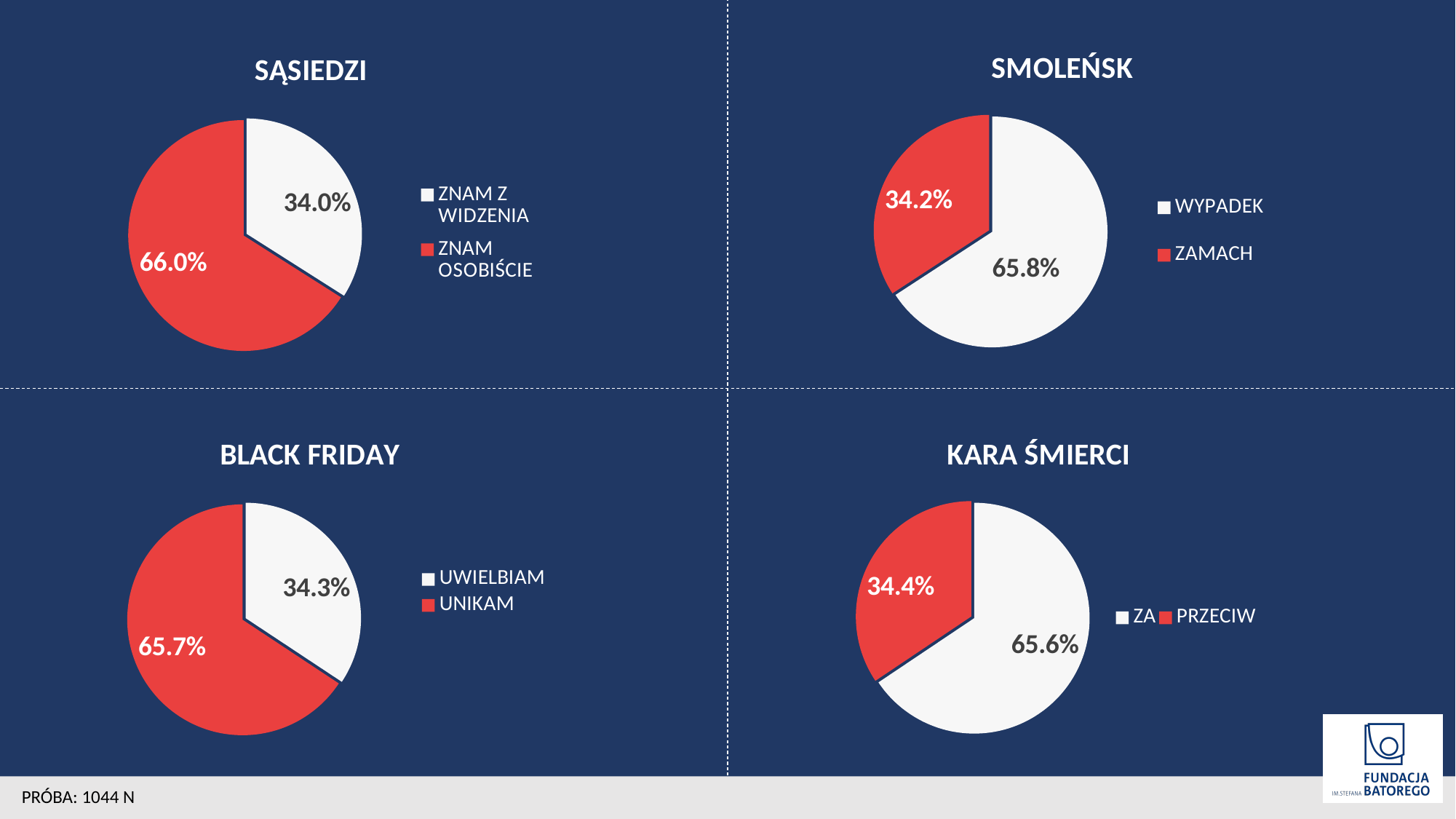
In the SĄSIEDZI chart, what is the difference between ZNAM OSOBIŚCIE and ZNAM Z WIDZENIA? 32.0% What kind of chart is the KARA ŚMIERCI chart? Pie chart In the SMOLEŃSK chart, what is the value for ZAMACH? 34.2% In the SMOLEŃSK chart, which category has the largest share? WYPADEK How many slices does the BLACK FRIDAY pie chart have? 2 In the KARA ŚMIERCI chart, what is the value for ZA? 65.6% In the BLACK FRIDAY chart, what is the value for UNIKAM? 65.7% In the SĄSIEDZI chart, what is the value for ZNAM OSOBIŚCIE? 66.0% In the KARA ŚMIERCI chart, which slice is larger, ZA or PRZECIW? ZA In the SMOLEŃSK chart, what is the value for WYPADEK? 65.8% In the BLACK FRIDAY chart, which category has the smallest share? UWIELBIAM In the SĄSIEDZI chart, what is the value for ZNAM Z WIDZENIA? 34.0%